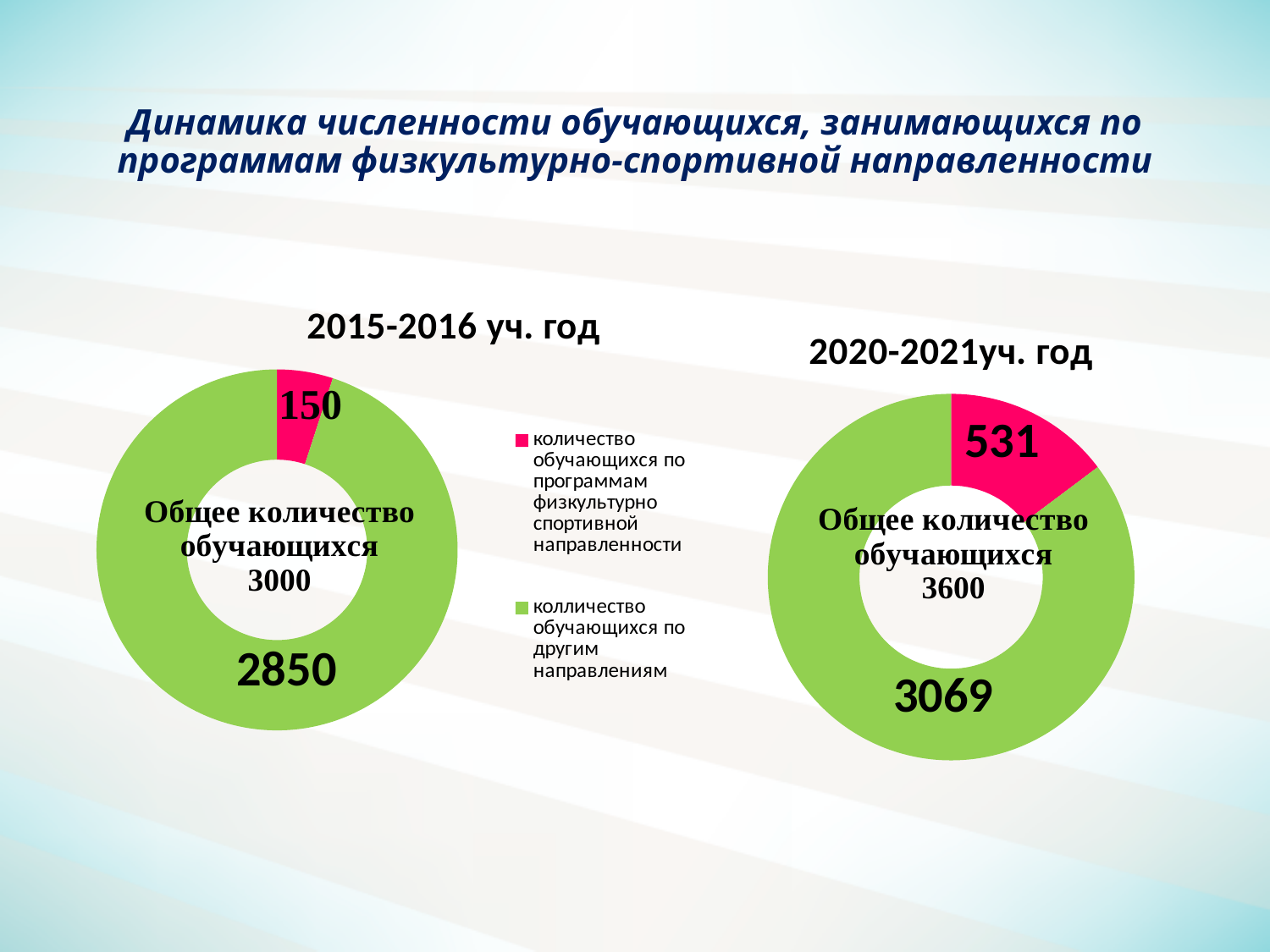
In the chart titled "2020-2021уч. год", what is the value for "колличество обучающихся по другим направлениям"? 3069 In the chart titled "2015-2016 уч. год", what is the value for "количество обучающихся по программам физкультурно спортивной направленности"? 150 What kind of chart is the one titled "2015-2016 уч. год"? Doughnut chart In the chart titled "2015-2016 уч. год", what is the total of the two plotted values? 3000 In the chart titled "2015-2016 уч. год", what share of the total is the value 150? 5% In the chart titled "2020-2021уч. год", what is the difference between the two plotted values? 2538 In the chart titled "2015-2016 уч. год", which category has the smallest value? количество обучающихся по программам физкультурно спортивной направленности In the chart titled "2015-2016 уч. год", what is the value for "колличество обучающихся по другим направлениям"? 2850 In the chart titled "2020-2021уч. год", what is the value for "количество обучающихся по программам физкультурно спортивной направленности"? 531 In the chart titled "2020-2021уч. год", what is the total of the two plotted values? 3600 In the chart titled "2020-2021уч. год", which category has the largest value? колличество обучающихся по другим направлениям How many entries does the legend between the two charts list? 2